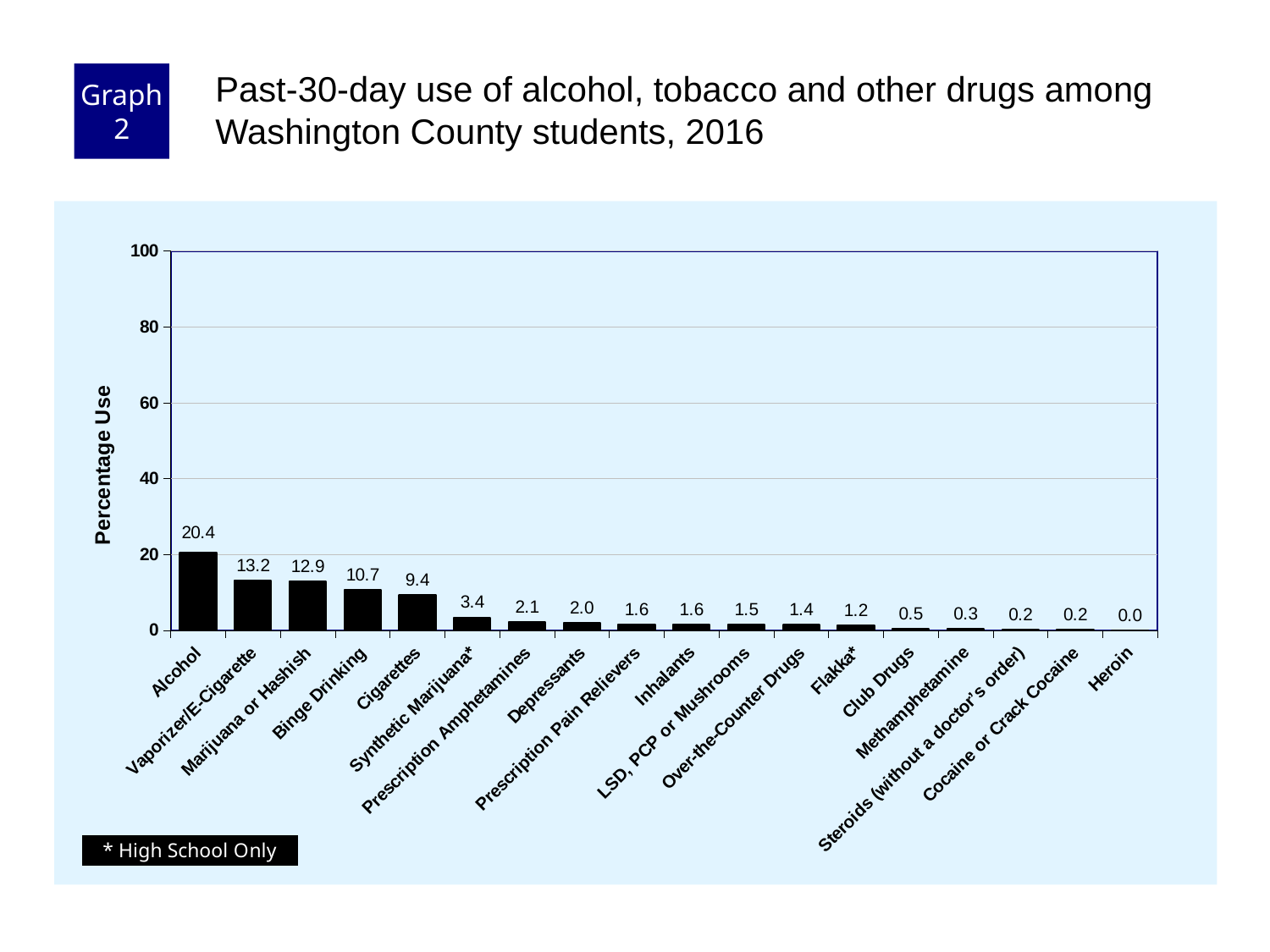
What is the difference in percentage use between Vaporizer/E-Cigarette and Marijuana or Hashish? 0.3 How many categories are shown on the x axis? 18 What is the percentage use for Binge Drinking? 10.7 Which has a higher percentage use, Binge Drinking or Cigarettes? Binge Drinking What is the percentage use for Heroin? 0.0 Which category has the lowest percentage use? Heroin What is the difference in percentage use between Alcohol and Cigarettes? 11.0 Is the value for Alcohol greater or less than 40? less What kind of chart is shown on the slide? Bar chart What is the percentage use for Alcohol? 20.4 Which category has the highest percentage use? Alcohol What is the percentage use for Synthetic Marijuana*? 3.4